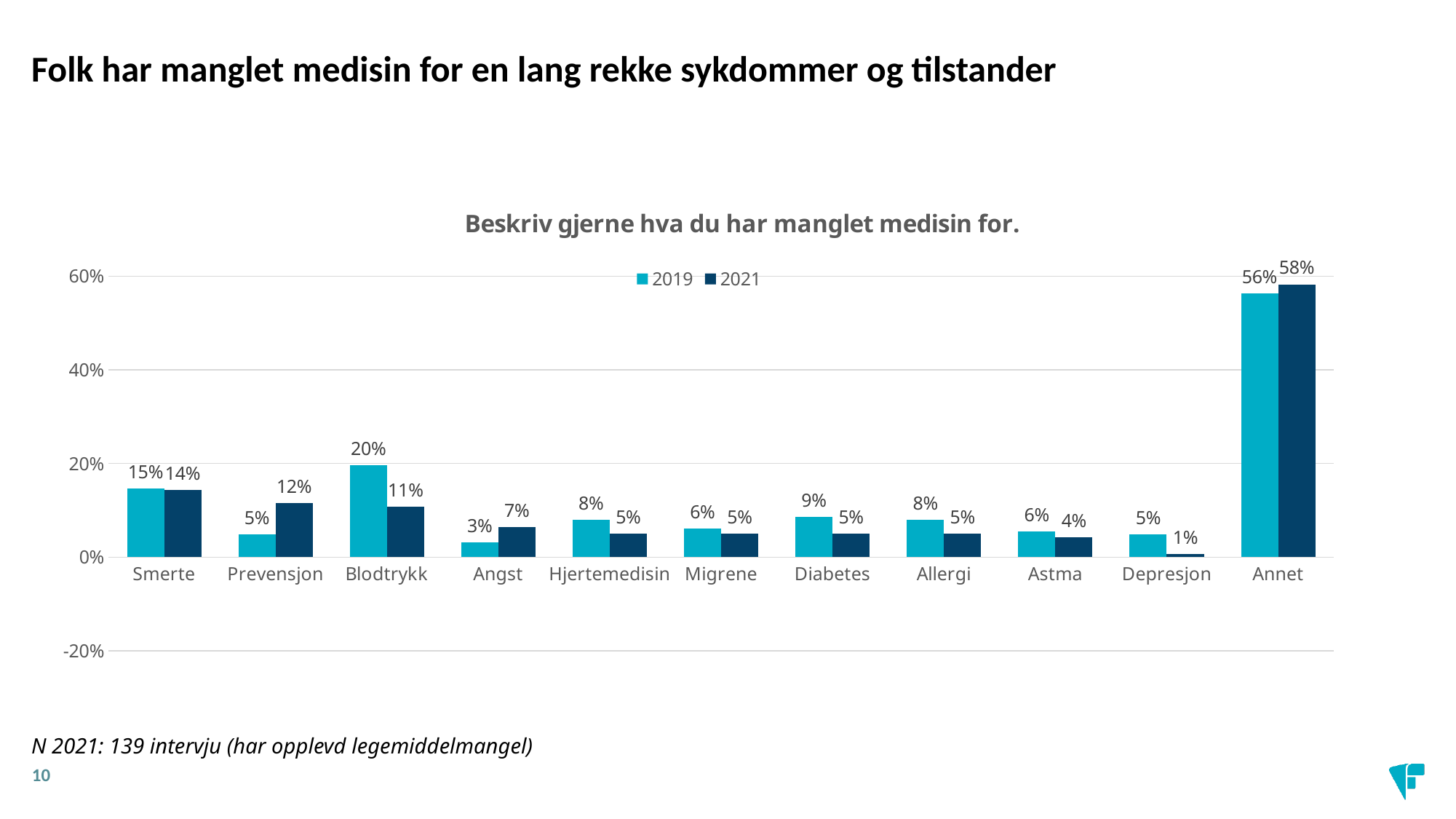
What is the 2019 value for Blodtrykk? 20% Which category has the lowest 2021 value? Depresjon What is the difference between the 2019 and 2021 values for Blodtrykk? 9% Is the 2019 value for Annet greater or less than 40%? greater Which is larger for Prevensjon, the 2019 value or the 2021 value? 2021 Which category has the highest 2021 value? Annet How many series does the legend list? 2 How many categories are shown on the x axis? 11 What is the 2021 value for Depresjon? 1% What is the 2021 value for Prevensjon? 12% What kind of chart is shown on the slide? Bar chart What is the title of the chart? Beskriv gjerne hva du har manglet medisin for.